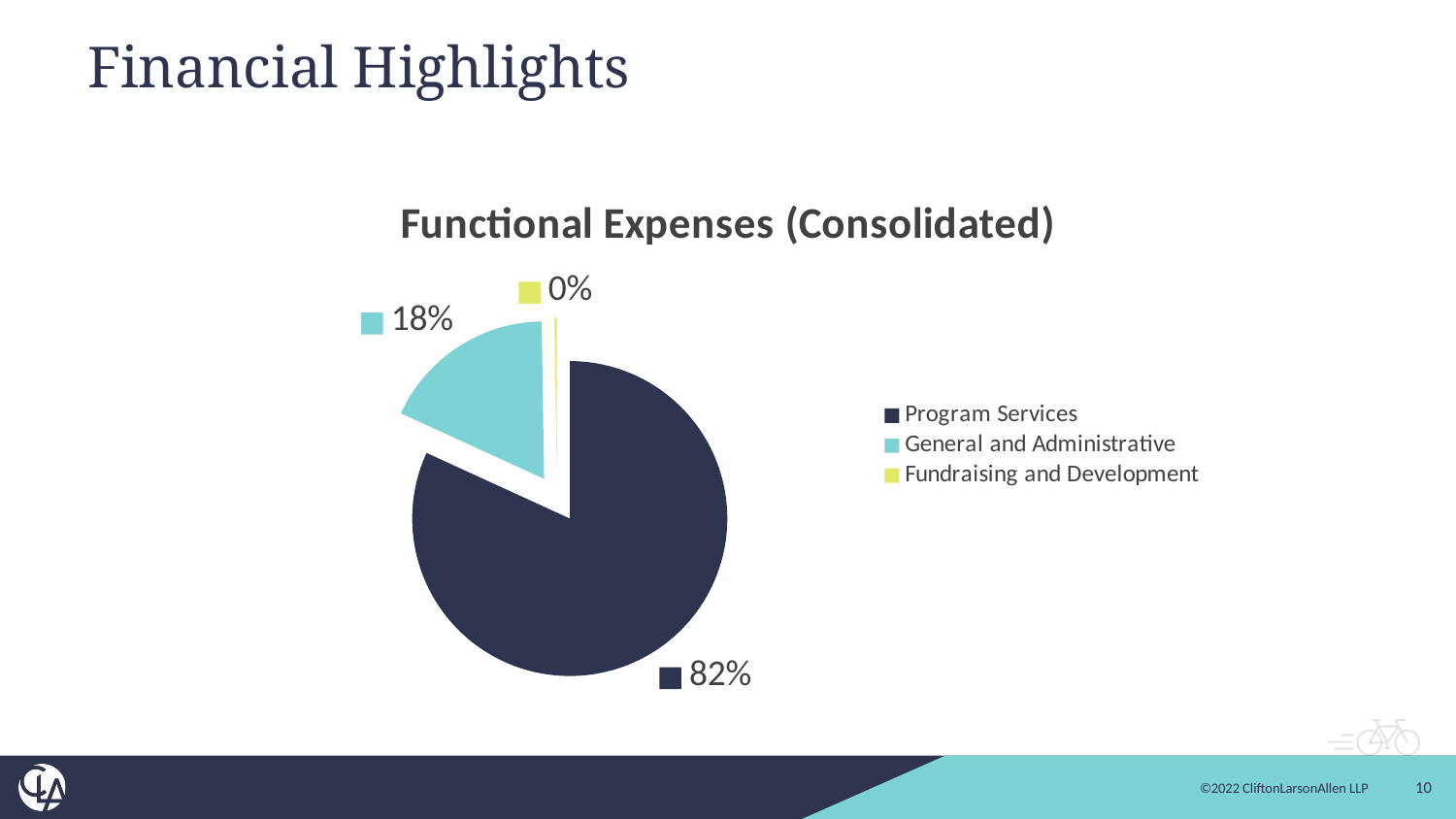
What percentage of functional expenses is Fundraising and Development? 0% What colour represents General and Administrative in the chart? Teal (light blue) Is the share for Program Services greater or less than 50%? greater What percentage of functional expenses is Program Services? 82% What percentage of functional expenses is General and Administrative? 18% What type of chart is shown on the slide? Pie chart Which is larger, the share for General and Administrative or the share for Fundraising and Development? General and Administrative What is the difference in percentage points between Program Services and General and Administrative? 64 Which category has the smallest share of functional expenses? Fundraising and Development How many categories does the legend list? 3 What is the title of the chart? Functional Expenses (Consolidated) Which category has the largest share of functional expenses? Program Services